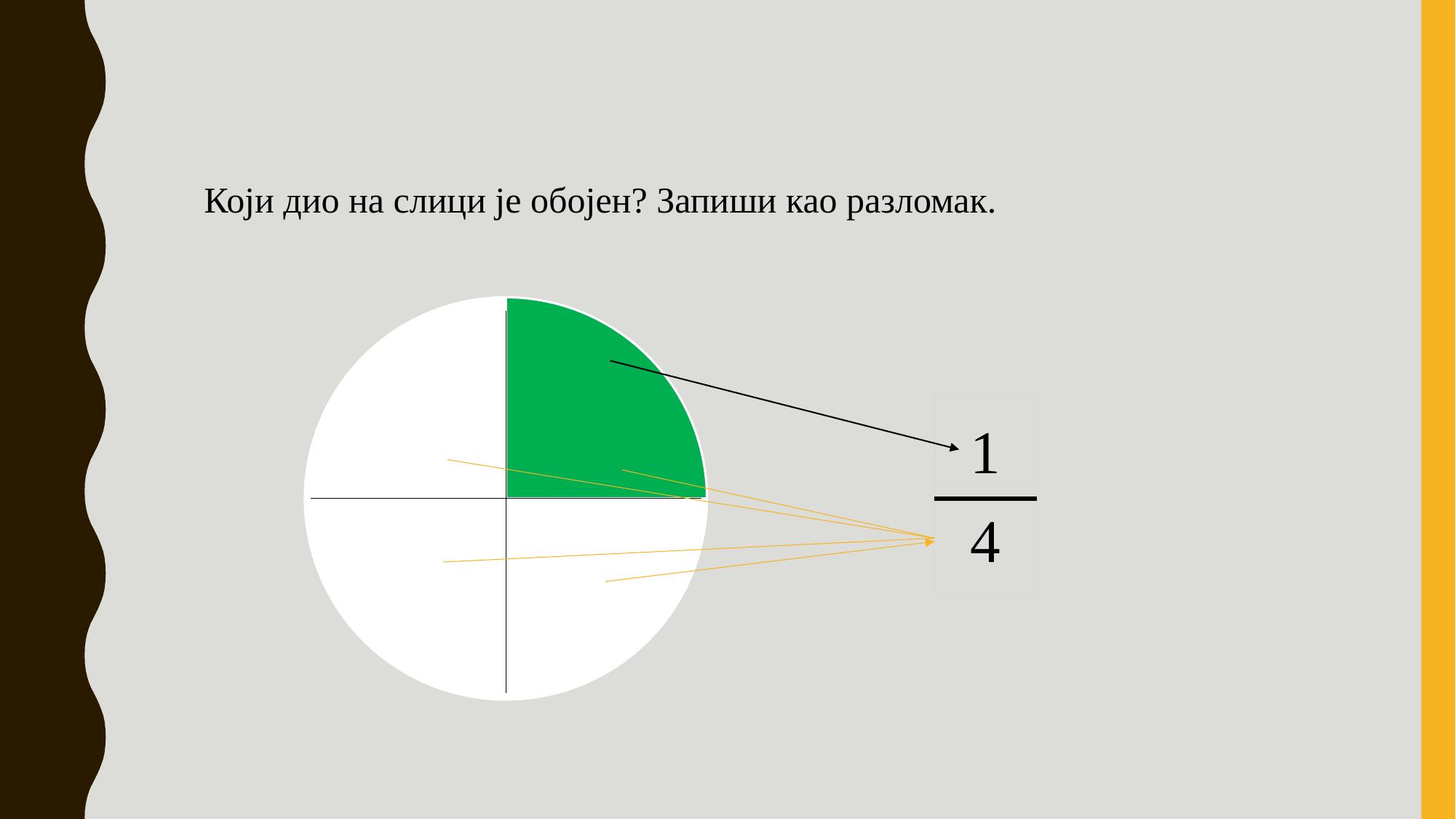
How many of the circle's parts are shaded? 1 Into how many equal parts is the circle on the slide divided? 4 Is the shaded part of the circle larger or smaller than the unshaded part? Smaller What colour is the shaded part of the circle? Green What fraction of the circle is shaded, as written on the slide? 1/4 What number is written as the denominator of the fraction on the slide? 4 What number is written as the numerator of the fraction on the slide? 1